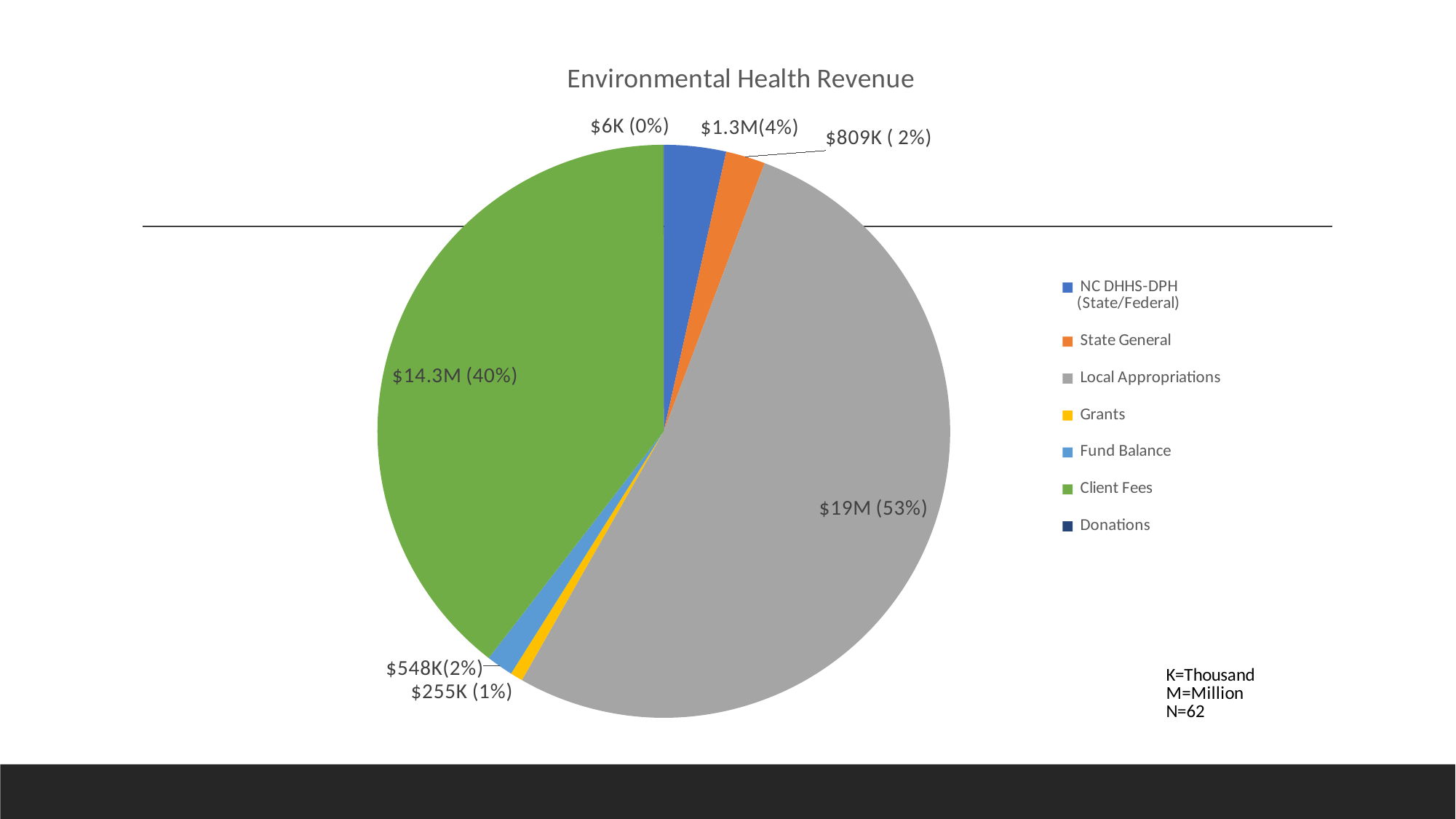
How many categories does the legend list? 7 Which category has the largest share of the pie? Local Appropriations What percentage share of the pie does Fund Balance have? 2% What is the value shown for NC DHHS-DPH (State/Federal)? $1.3M(4%) What is the value shown for Local Appropriations? $19M (53%) Which is larger, Client Fees or Local Appropriations? Local Appropriations What is the value shown for State General? $809K ( 2%) What is the title of the chart? Environmental Health Revenue What is the value shown for Client Fees? $14.3M (40%) What type of chart is shown on the slide? pie chart Which category has the smallest share of the pie? Donations What is the value shown for Grants? $255K (1%)